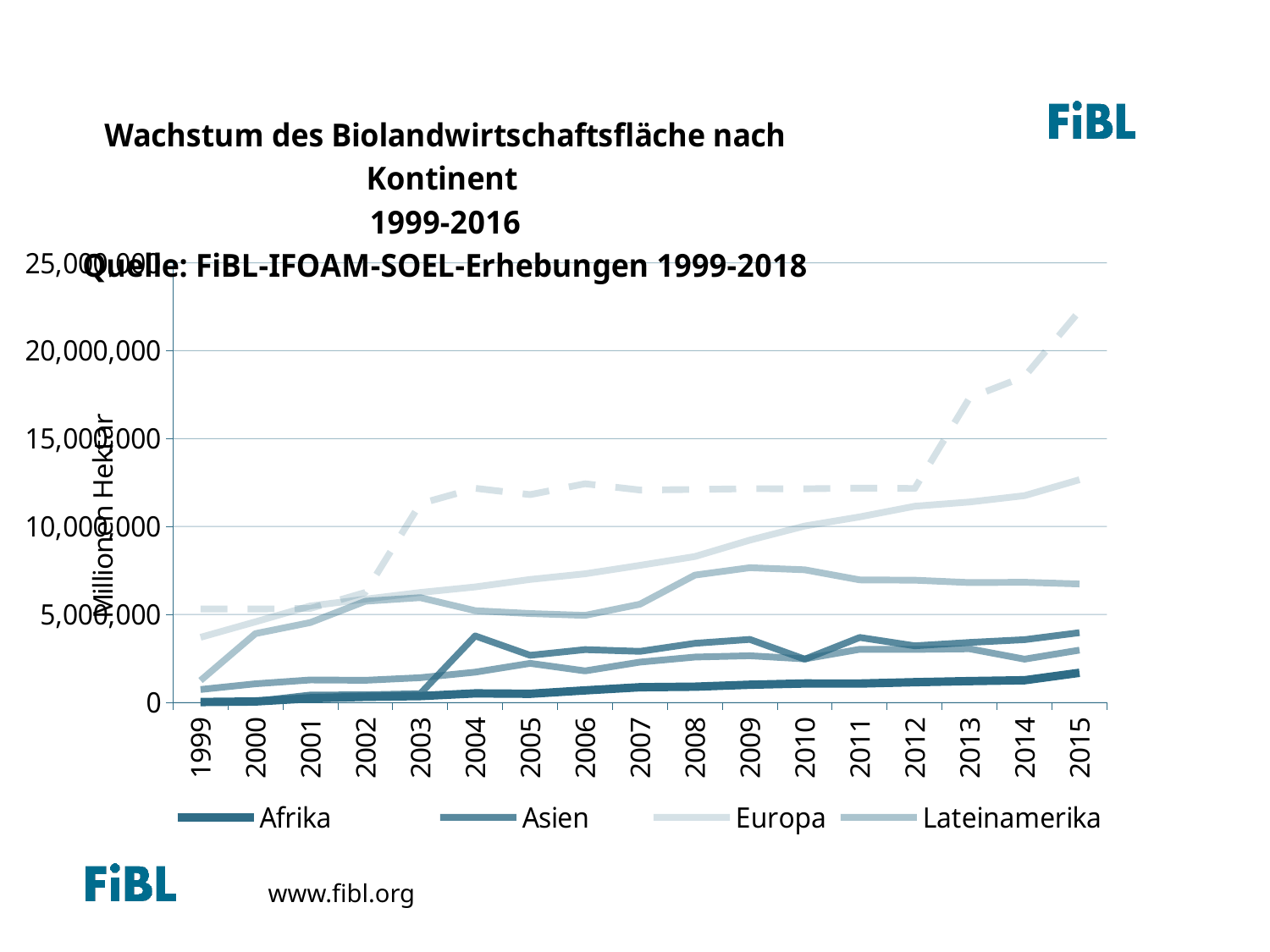
Is the value for Afrika in 2015 greater or less than 5,000,000? less How many series does the chart legend list? 4 Which is larger in 2015, the value for Lateinamerika or the value for Asien? Lateinamerika What is the label of the y axis of the chart? Millionen Hektar Is the value for Lateinamerika in 2015 greater or less than 5,000,000? greater Is the value for Europa in 1999 greater or less than 5,000,000? less What kind of chart is shown on the slide? line chart How many years are shown along the x axis of the chart? 17 Which is larger in 2015, the value for Europa or the value for Afrika? Europa Does the Europa line rise or fall from 1999 to 2015? rise What is the first year shown on the x axis of the chart? 1999